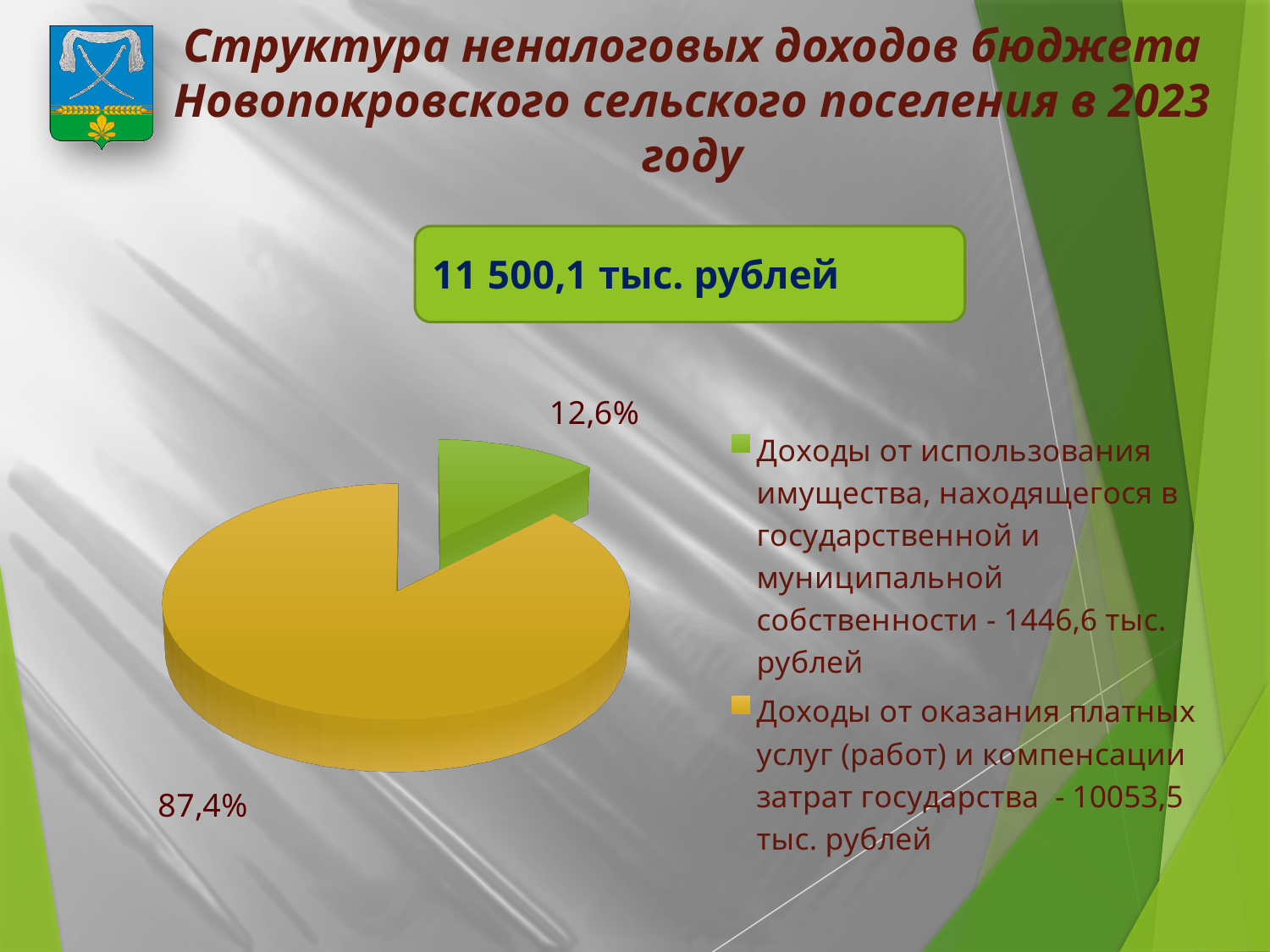
What total amount is shown in the green box above the chart? 11 500,1 тыс. рублей What is the difference in percentage points between the two slices of the pie (87,4% and 12,6%)? 74,8 Which is larger: the share for Доходы от оказания платных услуг or the share for Доходы от использования имущества? Доходы от оказания платных услуг According to the legend, what is the value for Доходы от оказания платных услуг (работ) и компенсации затрат государства? 10053,5 тыс. рублей What kind of chart is shown on the slide? pie chart How many slices does the pie chart have? 2 Which category has the largest slice of the pie? Доходы от оказания платных услуг (работ) и компенсации затрат государства What share of the pie is labelled for the green slice (Доходы от использования имущества, находящегося в государственной и муниципальной собственности)? 12,6% What share of the pie is labelled for the yellow slice (Доходы от оказания платных услуг (работ) и компенсации затрат государства)? 87,4% Which category has the smallest slice of the pie? Доходы от использования имущества, находящегося в государственной и муниципальной собственности According to the legend, what is the value for Доходы от использования имущества, находящегося в государственной и муниципальной собственности? 1446,6 тыс. рублей How many entries does the legend list? 2